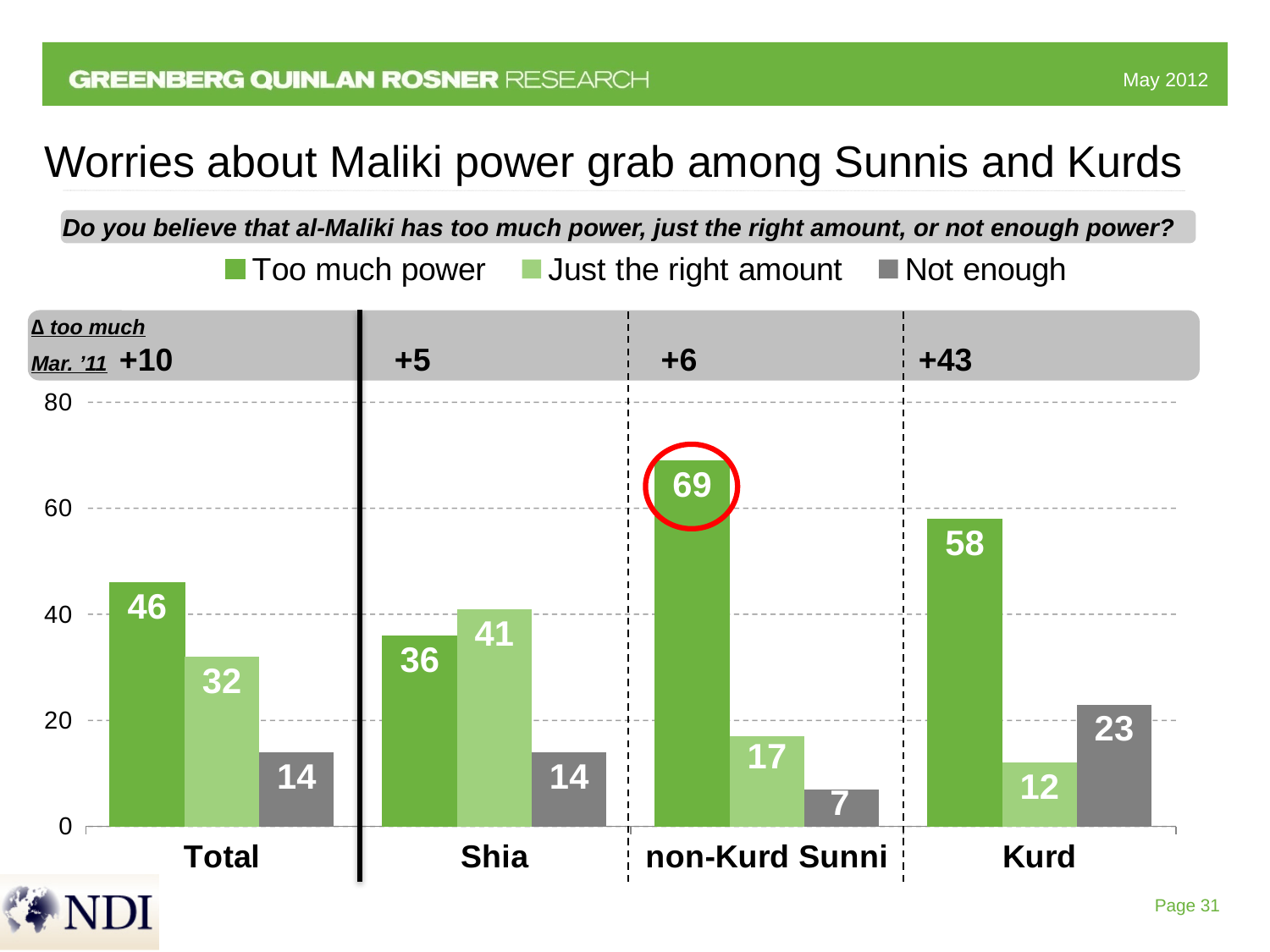
What is the difference between the "Too much power" values for Kurd and Total? 12 How many groups are shown on the x axis? 4 What kind of chart is shown? bar chart What is the change in "too much" since March 2011 shown for Kurds? +43 Which group has the lowest value for "Not enough"? non-Kurd Sunni What is the value for "Not enough" among Kurds? 23 What is the value for "Just the right amount" among Shia? 41 Is the "Too much power" value for Kurd greater or less than 60? less Which group has the highest value for "Too much power"? non-Kurd Sunni Which is larger for Shia: "Too much power" or "Just the right amount"? Just the right amount What is the value for "Too much power" among non-Kurd Sunni? 69 How many series does the legend list? 3